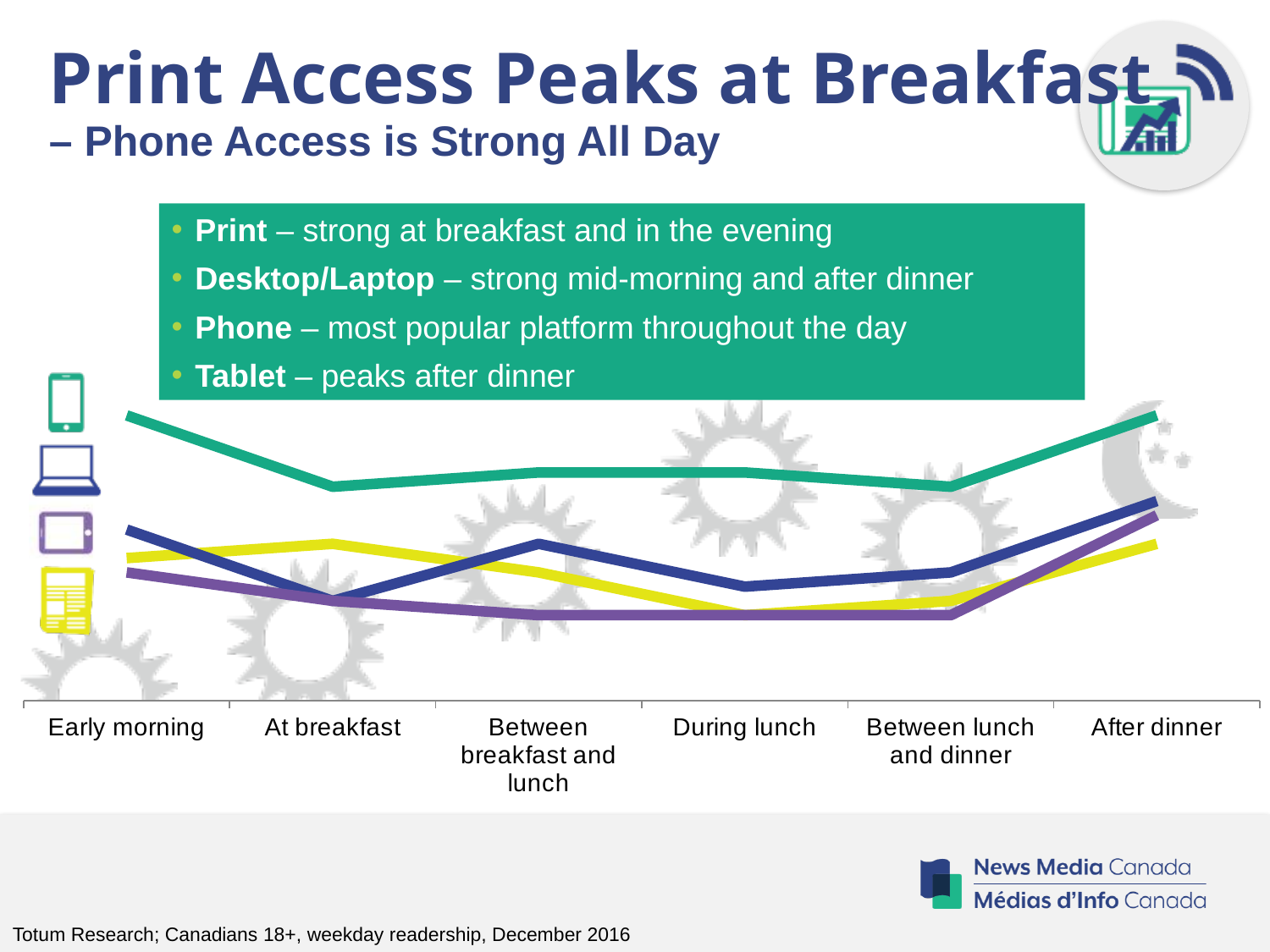
What kind of chart is shown on the slide? Line chart At breakfast, which line is higher: the print (yellow) line or the desktop/laptop (blue) line? Print (yellow) How many lines (platforms) are plotted on the chart? 4 At which time period does the desktop/laptop (blue) line reach its highest point? After dinner What is the title of the slide containing the chart? Print Access Peaks at Breakfast – Phone Access is Strong All Day What is the data source cited at the bottom of the slide? Totum Research; Canadians 18+, weekday readership, December 2016 Does the phone (green) line rise or fall from Early morning to At breakfast? Fall At which time period does the tablet (purple) line reach its highest point? After dinner Which platform's line is the highest across all time periods on the chart? Phone (green line) After dinner, which line is higher: the desktop/laptop (blue) line or the print (yellow) line? Desktop/laptop (blue) How many time-of-day categories are shown along the x axis of the chart? 6 Does the tablet (purple) line rise or fall from Between lunch and dinner to After dinner? Rise